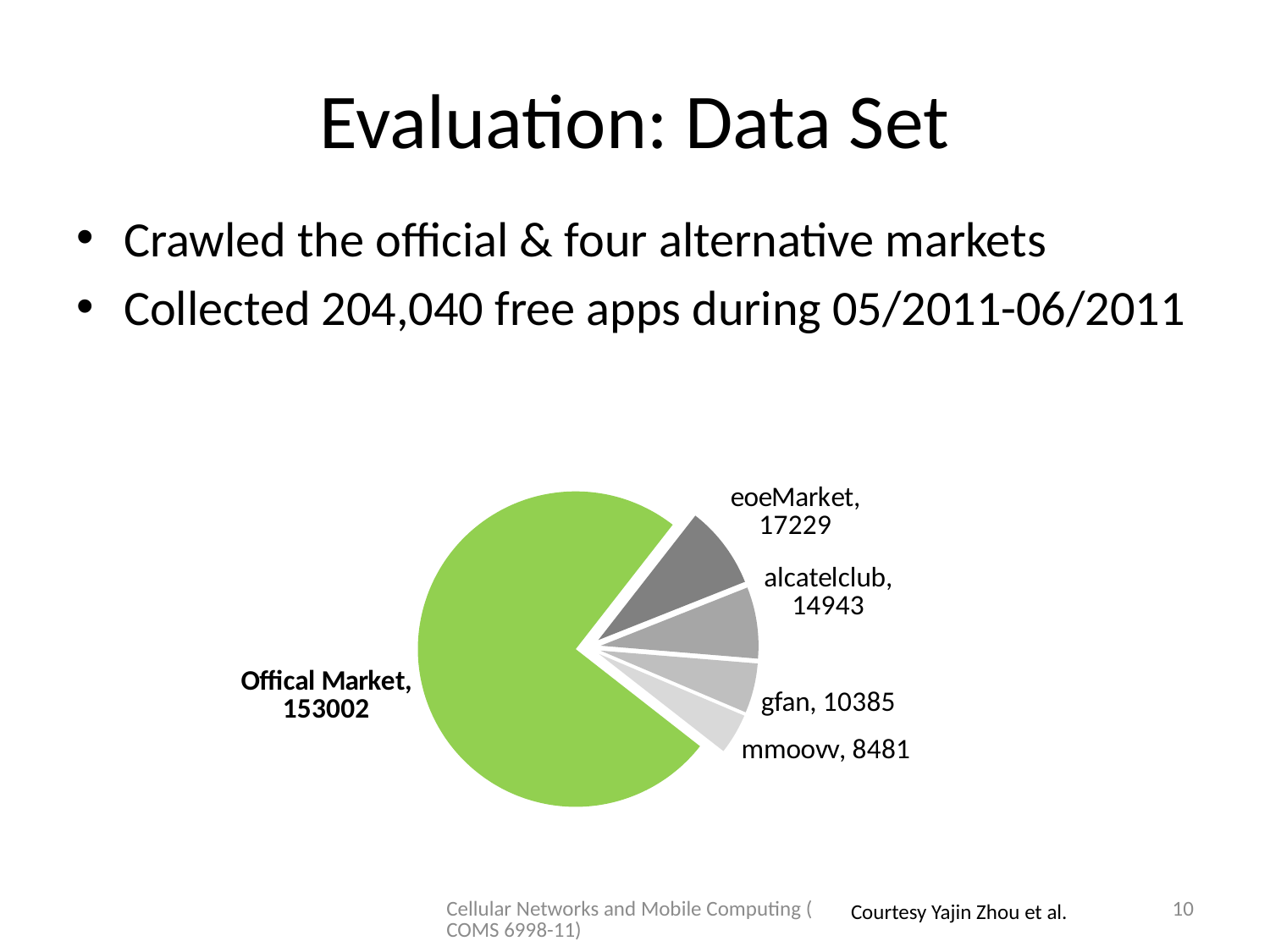
What is the difference between the Offical Market value and the eoeMarket value? 135773 What type of chart is shown on the slide? pie chart What is the value for mmoovv in the pie chart? 8481 What is the value for alcatelclub in the pie chart? 14943 What is the total of all slices in the pie chart? 204040 What is the value for eoeMarket in the pie chart? 17229 Which slice of the pie chart is the largest? Offical Market What is the value for gfan in the pie chart? 10385 What is the difference between the gfan value and the mmoovv value? 1904 Which is larger, the value for alcatelclub or the value for gfan? alcatelclub How many slices does the pie chart have? 5 Which slice of the pie chart is the smallest? mmoovv